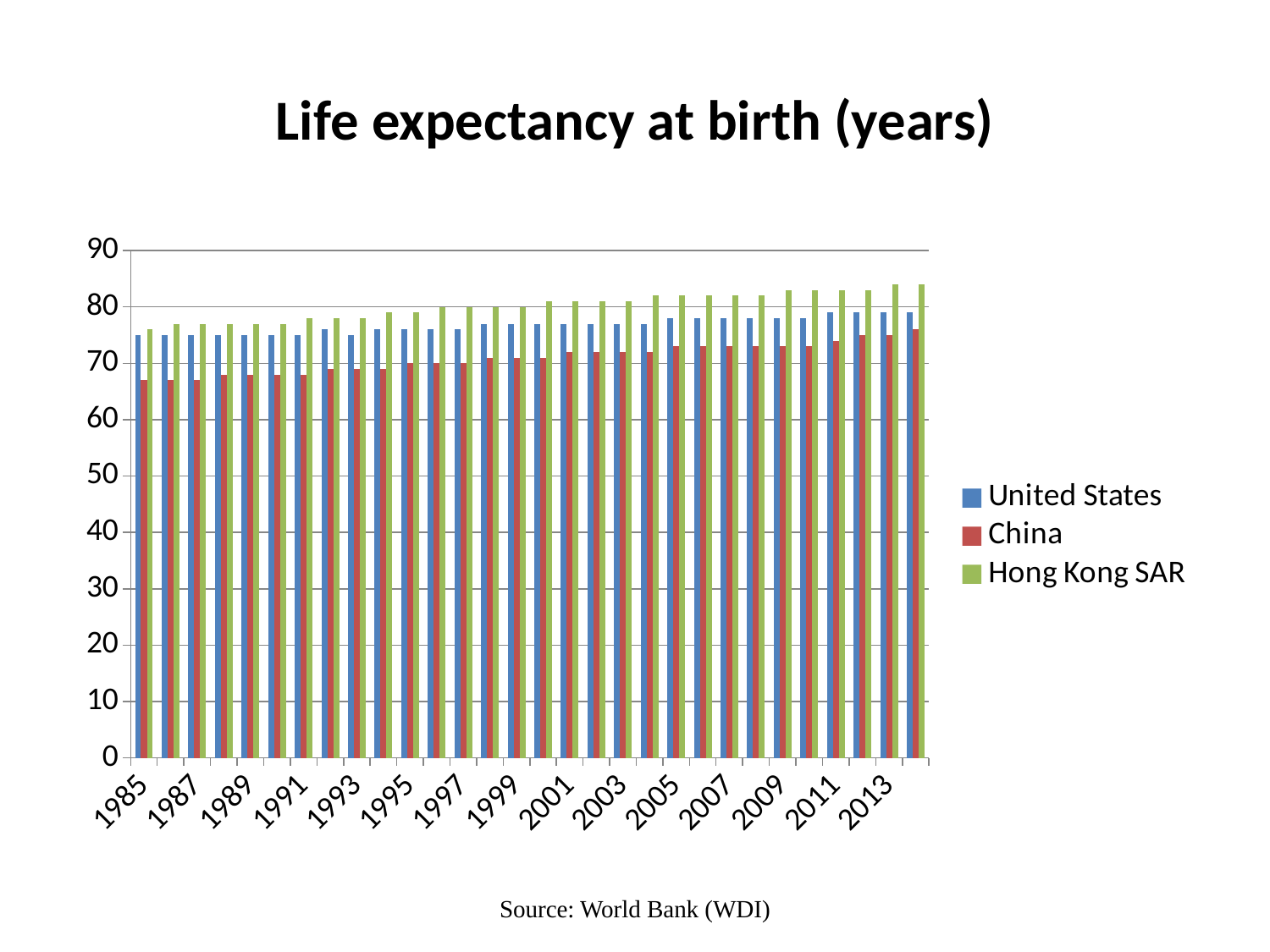
Which series has the highest value in 2013? Hong Kong SAR Which series has the lowest value in 1985? China Is the value for China in 2013 greater or less than 70? greater Do the values for China rise or fall from 1985 to 2013? rise Is the value for China in 1985 greater or less than 70? less How many series does the legend list? 3 Which series is shown in green in the legend? Hong Kong SAR Is the value for United States in 1985 greater or less than 70? greater What kind of chart is shown on the slide? bar chart What is the title of the chart? Life expectancy at birth (years)